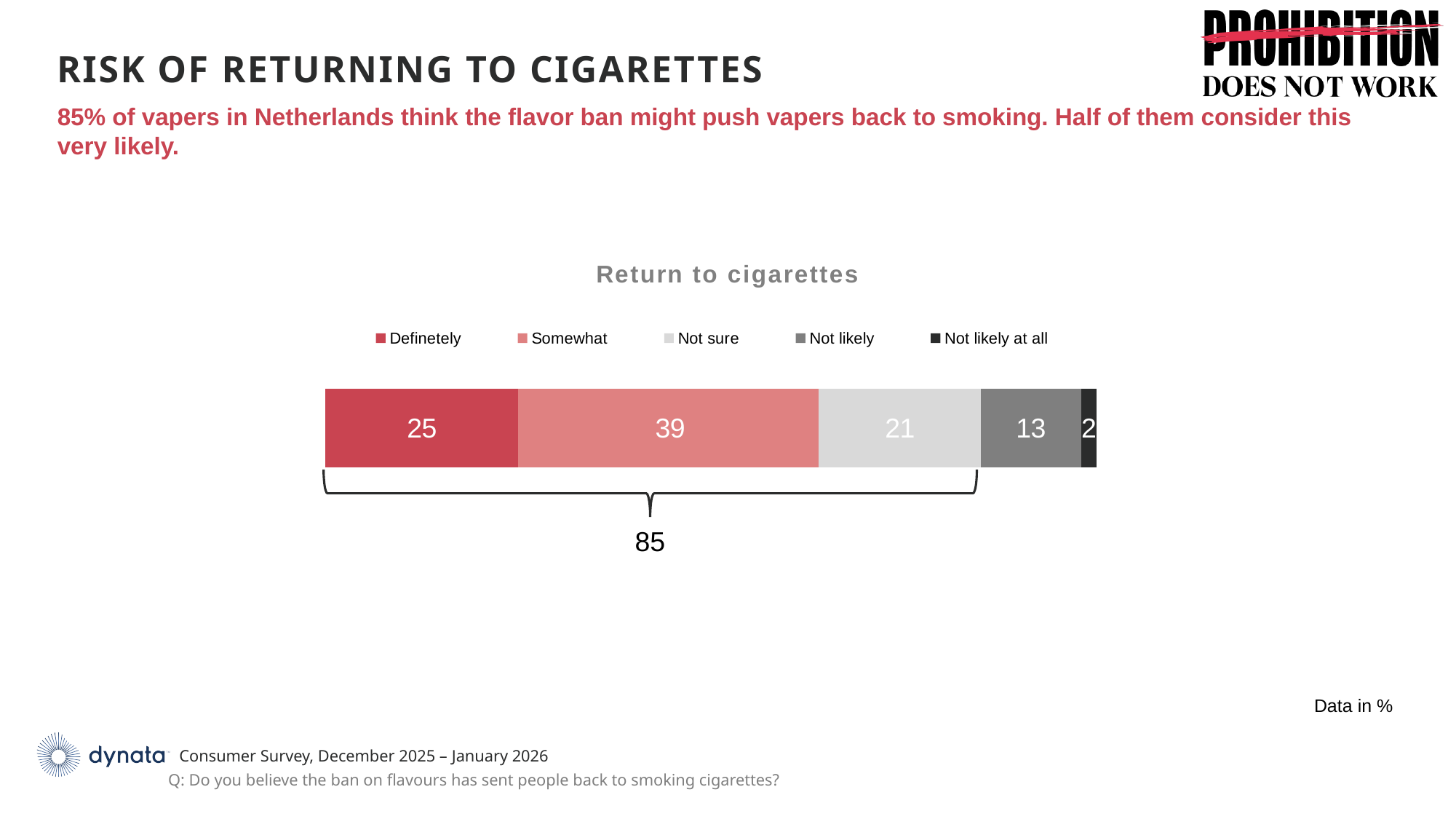
What total is shown by the bracket under the Definetely, Somewhat and Not sure segments in the Return to cigarettes chart? 85 What is the value for the Not likely at all segment in the Return to cigarettes chart? 2 What is the difference between the Somewhat and Definetely values in the Return to cigarettes chart? 14 What is the value for the Not sure segment in the Return to cigarettes chart? 21 Which is larger in the Return to cigarettes chart, Not sure or Not likely? Not sure Which segment has the highest value in the Return to cigarettes chart? Somewhat What kind of chart is the Return to cigarettes chart? Stacked bar chart Which segment has the lowest value in the Return to cigarettes chart? Not likely at all What is the value for the Not likely segment in the Return to cigarettes chart? 13 How many series does the legend of the Return to cigarettes chart list? 5 What is the value for the Definetely segment in the Return to cigarettes chart? 25 What is the value for the Somewhat segment in the Return to cigarettes chart? 39